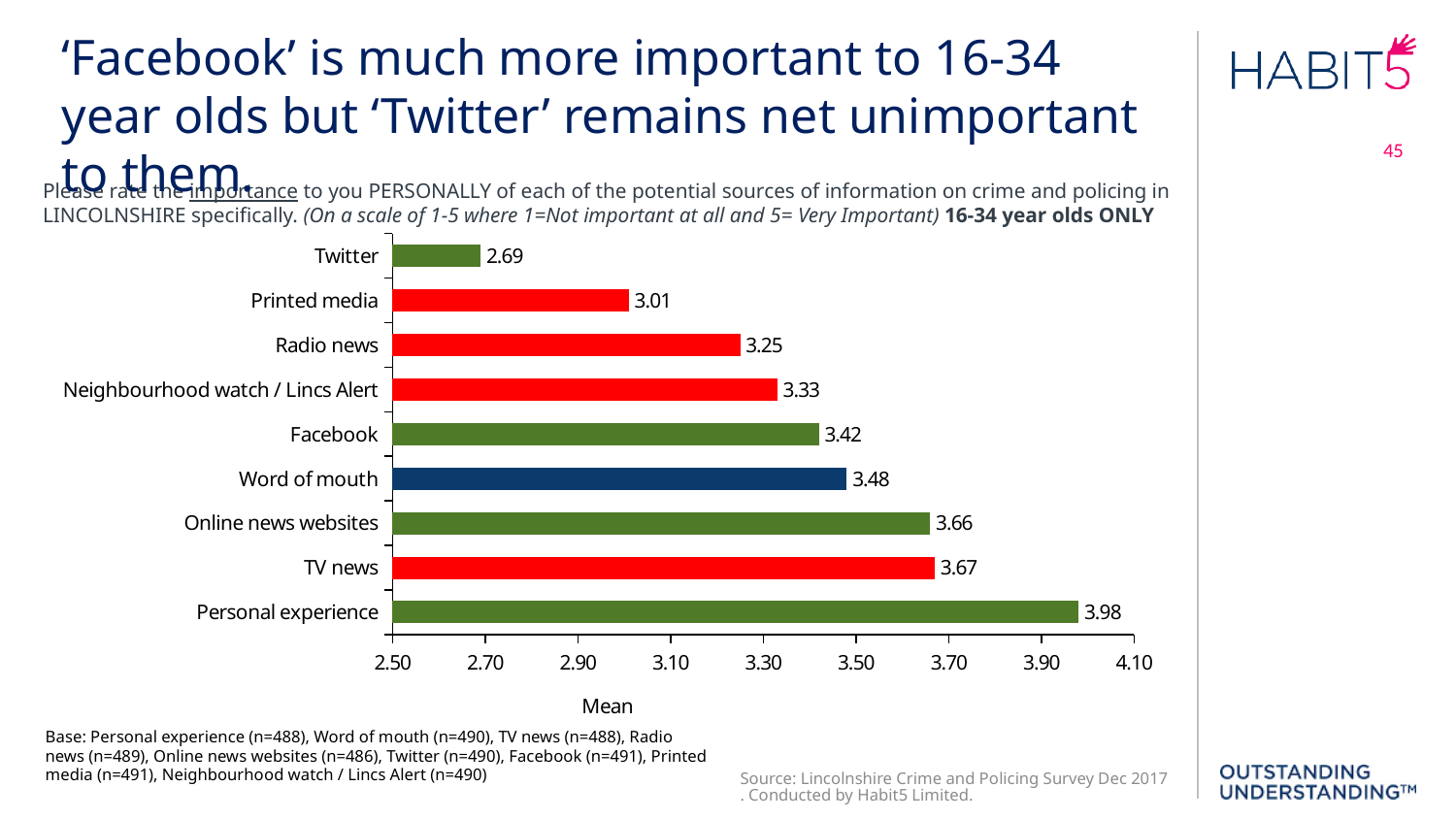
What is the difference between the mean scores for Facebook and Twitter? 0.73 What type of chart is shown on the slide? Bar chart What is the difference between the mean scores for Personal experience and Twitter? 1.29 What is the label on the horizontal axis of the chart? Mean Which source of information has the lowest mean importance score? Twitter What is the mean importance score for Twitter? 2.69 Which source of information has the highest mean importance score? Personal experience What is the mean importance score for Facebook? 3.42 How many sources of information are shown in the chart? 9 Which has a higher mean score, Facebook or Neighbourhood watch / Lincs Alert? Facebook What is the mean importance score for Word of mouth? 3.48 Which has a higher mean score, Radio news or Printed media? Radio news